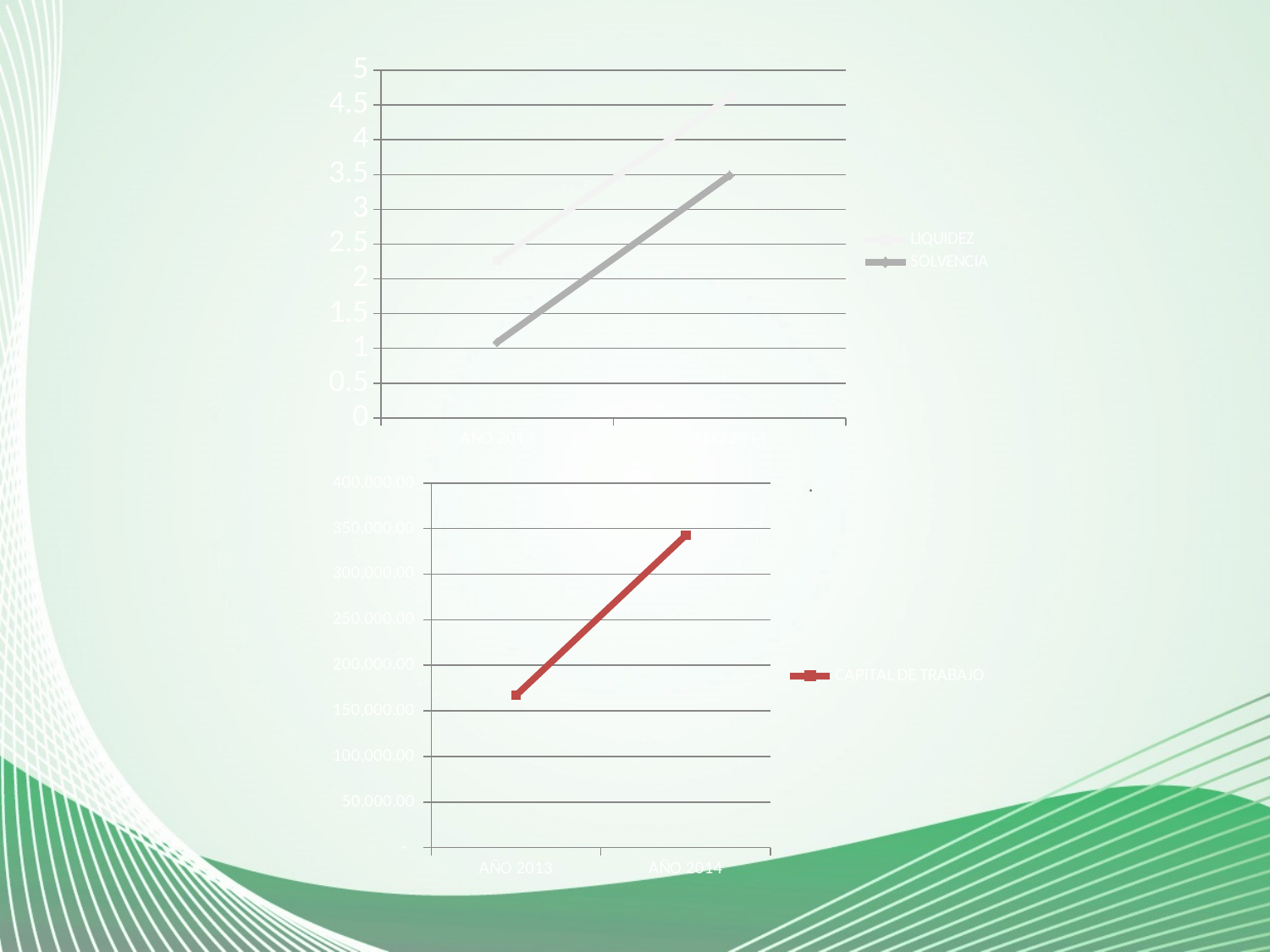
What series name does the legend of the bottom chart show? CAPITAL DE TRABAJO In the top chart, is the value for SOLVENCIA in AÑO 2013 greater or less than 1.5? less In the top chart, which series has the higher value in AÑO 2014, LIQUIDEZ or SOLVENCIA? LIQUIDEZ What kind of chart is the top chart on the slide? line chart In the top chart, is the value for SOLVENCIA in AÑO 2014 greater or less than 3? greater In the bottom chart, is the value for CAPITAL DE TRABAJO in AÑO 2014 greater or less than 300,000.00? greater How many series does the legend of the top chart list? 2 What are the two series named in the legend of the top chart? LIQUIDEZ and SOLVENCIA In the top chart, does the SOLVENCIA line rise or fall from AÑO 2013 to AÑO 2014? rises What kind of chart is the bottom chart on the slide? line chart